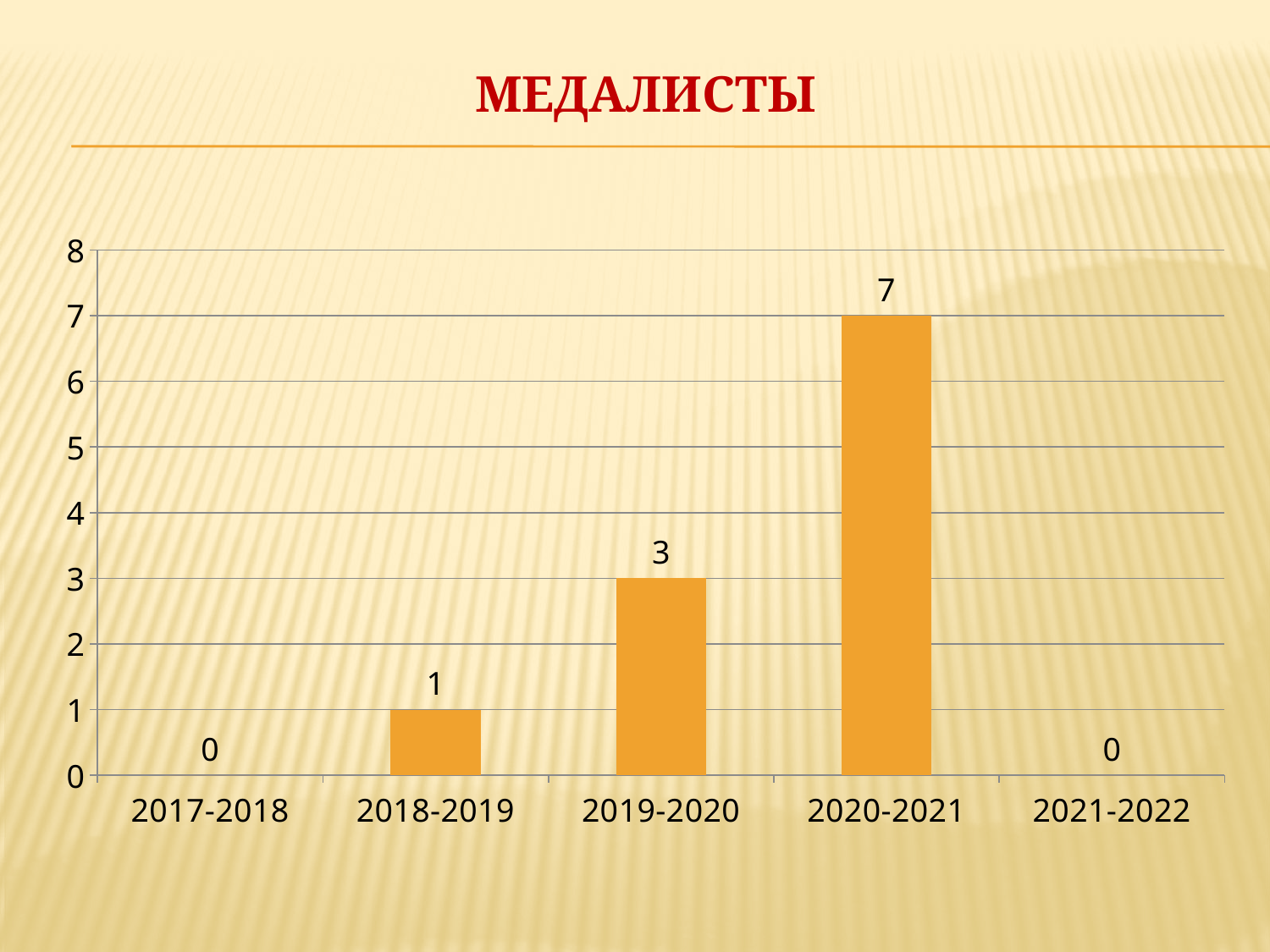
Which category has the highest value? 2020-2021 What is the value for 2019-2020? 3 Which is larger, the value for 2018-2019 or the value for 2019-2020? 2019-2020 What is the value for 2017-2018? 0 What is the title of the slide? МЕДАЛИСТЫ What is the difference between the values for 2019-2020 and 2018-2019? 2 What kind of chart is shown on the slide? bar chart Is the value for 2020-2021 greater or less than 5? greater What is the value for 2020-2021? 7 What is the value for 2018-2019? 1 What is the difference between the values for 2020-2021 and 2019-2020? 4 How many categories are shown on the x axis? 5